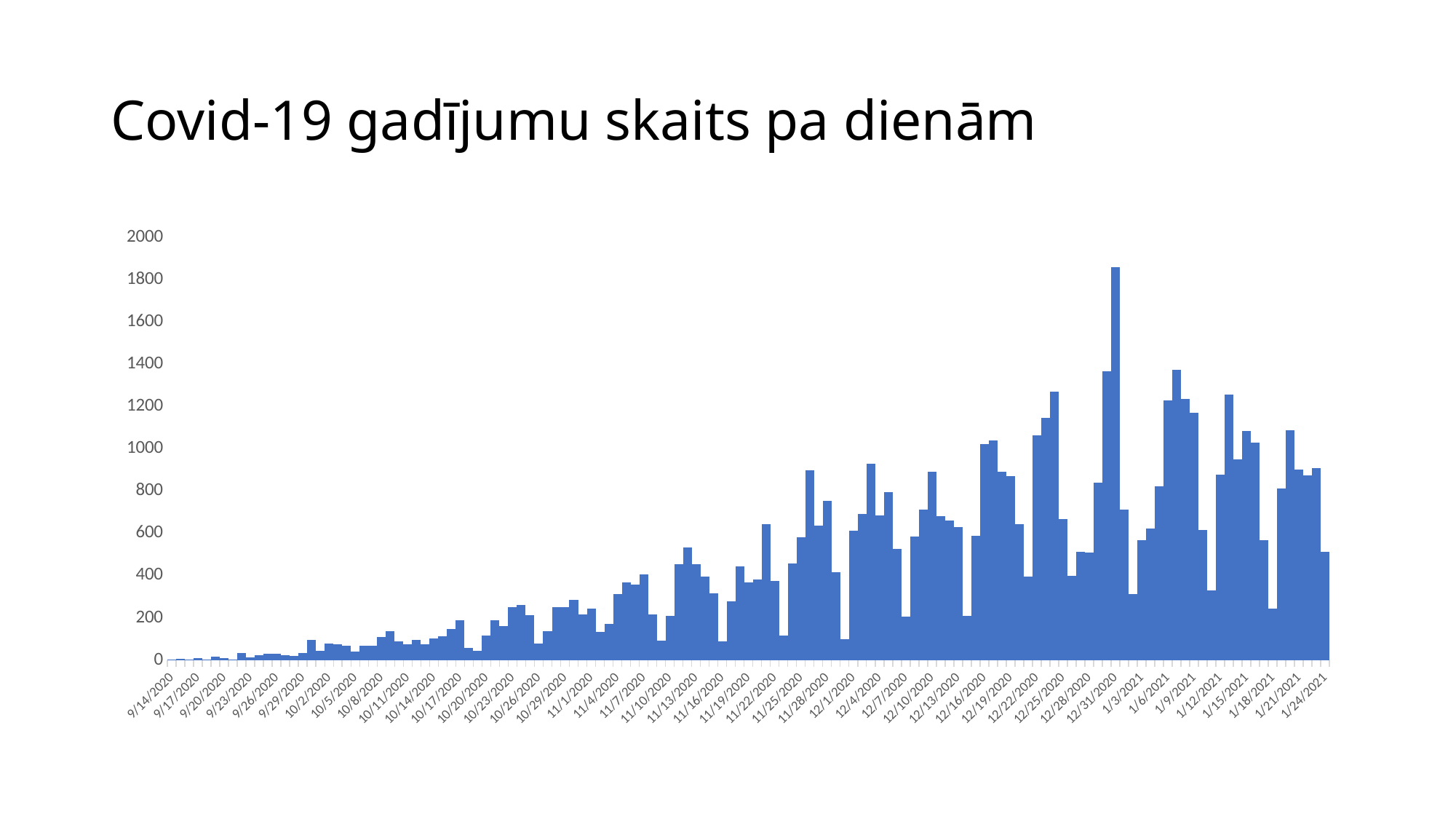
Is the value of the tallest bar greater or less than 1600? greater Which is larger, the value for 9/14/2020 or the value for 1/24/2021? 1/24/2021 What is the highest value shown on the vertical axis? 2000 What is the first date label on the horizontal axis? 9/14/2020 What kind of chart is shown on the slide? bar chart Overall, do the daily values rise or fall from 9/14/2020 to 1/24/2021? rise Around which date label does the tallest bar occur? 12/31/2020 Is the value for 1/24/2021 greater or less than 600? less Is the value for 9/14/2020 greater or less than 200? less What is the last date label on the horizontal axis? 1/24/2021 What is the title of the chart? Covid-19 gadījumu skaits pa dienām